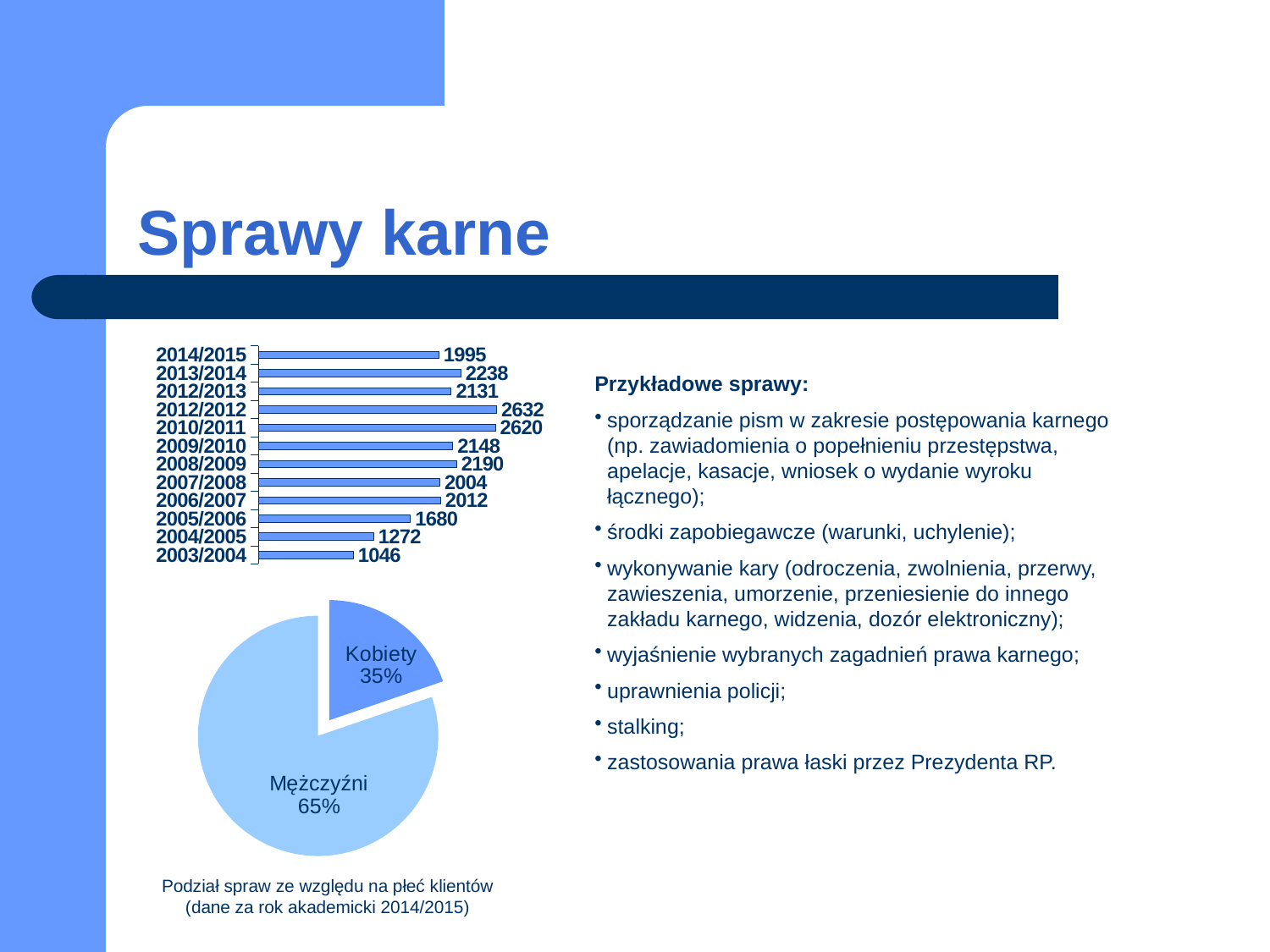
In the bar chart at the top left, what is the value for 2003/2004? 1046 In the bar chart at the top left, which category has the lowest value? 2003/2004 How many categories does the bar chart at the top left show? 12 In the pie chart at the bottom left, which slice is larger, Kobiety or Mężczyźni? Mężczyźni What kind of chart is the chart at the top left of the slide? bar chart In the bar chart at the top left, what is the difference between the values for 2013/2014 and 2012/2013? 107 What is the title of the pie chart at the bottom left? Podział spraw ze względu na płeć klientów (dane za rok akademicki 2014/2015) In the bar chart at the top left, what is the value for 2008/2009? 2190 In the bar chart at the top left, which category has the highest value? 2012/2012 In the bar chart at the top left, what is the value for 2014/2015? 1995 In the pie chart at the bottom left, what share does Kobiety have? 35% In the bar chart at the top left, which is larger, the value for 2005/2006 or the value for 2004/2005? 2005/2006